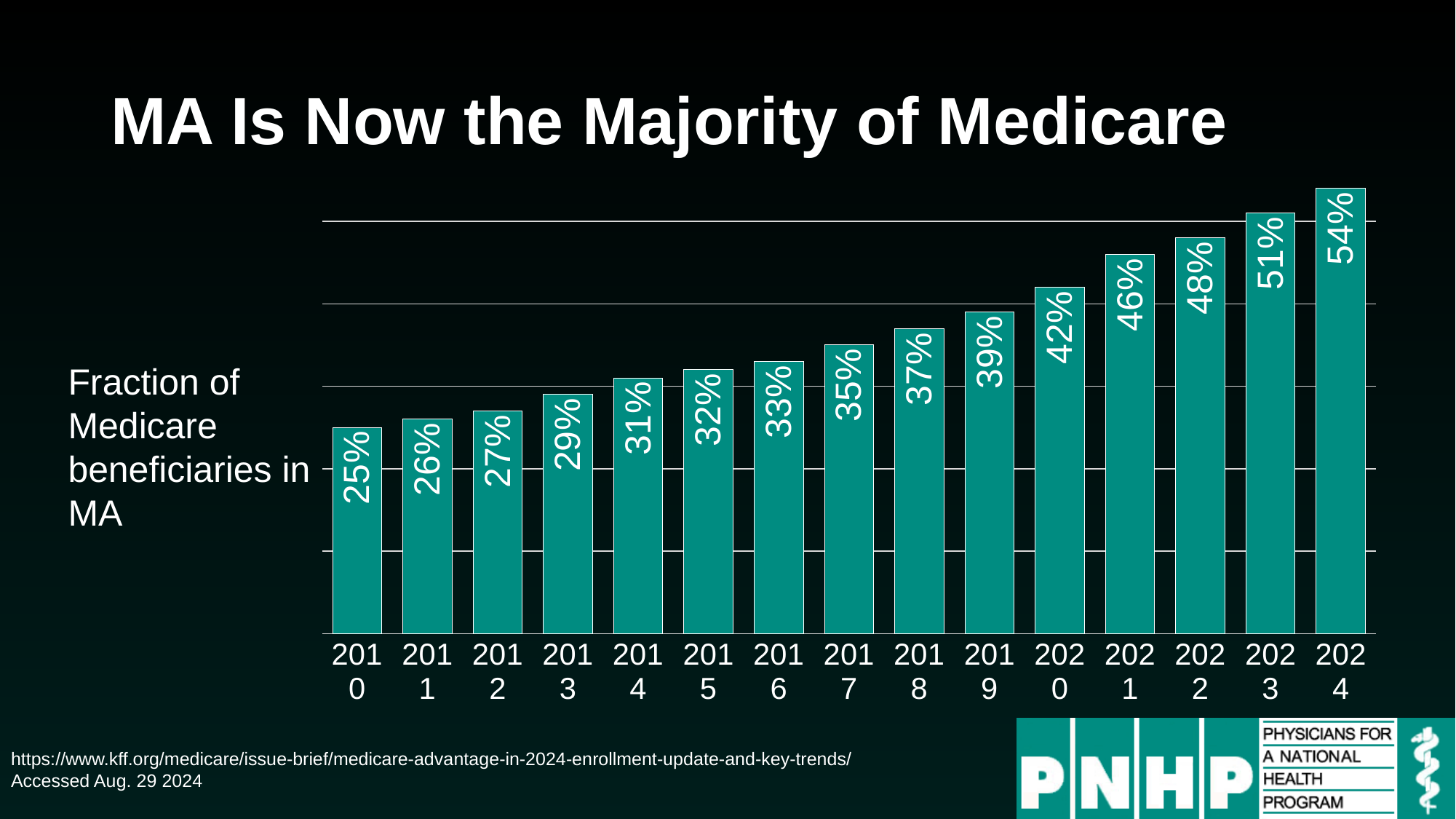
What value is shown for 2017? 35% What value is shown for 2021? 46% What is the difference between the 2024 value and the 2010 value? 29 percentage points What is the difference between the 2020 value and the 2019 value? 3 percentage points How many years are shown on the x axis? 15 What is the fraction of Medicare beneficiaries in MA in 2024? 54% Which year has the highest fraction of Medicare beneficiaries in MA? 2024 What is the fraction of Medicare beneficiaries in MA in 2010? 25% What kind of chart is shown on the slide? Bar chart Which is larger, the value for 2015 or the value for 2018? 2018 Which year has the lowest fraction of Medicare beneficiaries in MA? 2010 Do the values rise or fall from 2010 to 2024? Rise